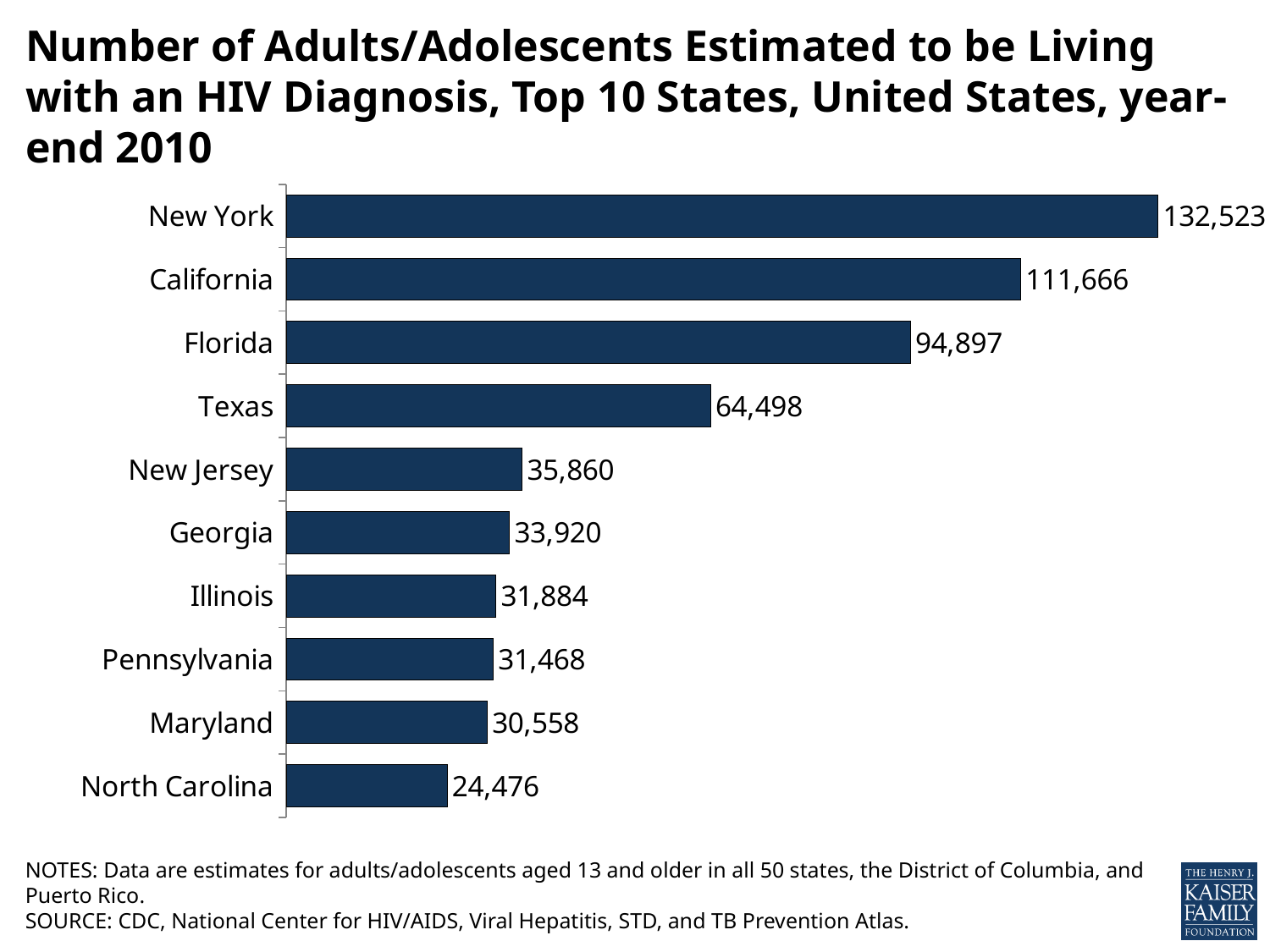
What is the value for Maryland? 30,558 Which state has the highest value? New York Which state has the lowest value? North Carolina What kind of chart is shown on the slide? Bar chart Which is larger, the value for New Jersey or the value for Georgia? New Jersey What is the value for New York? 132,523 What is the value for Texas? 64,498 How many states are shown in the chart? 10 Which is larger, the value for Illinois or the value for Pennsylvania? Illinois What is the difference between the values for Florida and Texas? 30,399 What is the source cited for the chart data? CDC, National Center for HIV/AIDS, Viral Hepatitis, STD, and TB Prevention Atlas What is the difference between the values for New York and California? 20,857